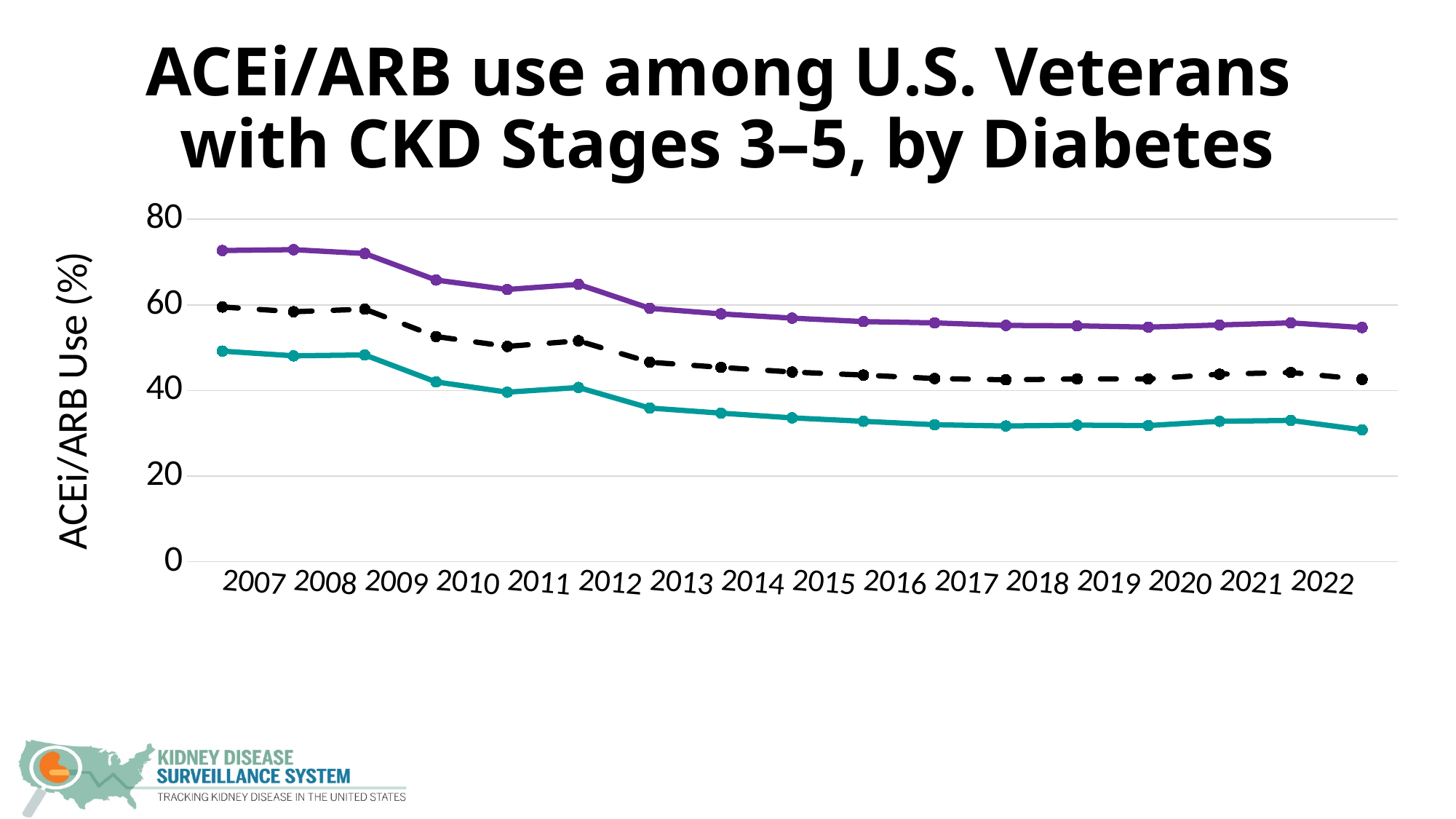
What is the label on the y axis? ACEi/ARB Use (%) What is the title of the chart? ACEi/ARB use among U.S. Veterans with CKD Stages 3–5, by Diabetes What kind of chart is shown on the slide? Line chart Is the value of the teal line in 2022 greater or less than 40? less Is the value of the teal line in 2007 greater or less than 40? greater Is the value of the purple line in 2022 greater or less than 60? less How many lines are plotted on the chart? 3 Overall, do the plotted values rise or fall from 2007 to 2022? Fall How many years are shown along the x axis? 16 In 2015, which line has the higher value, the purple line or the teal line? Purple line